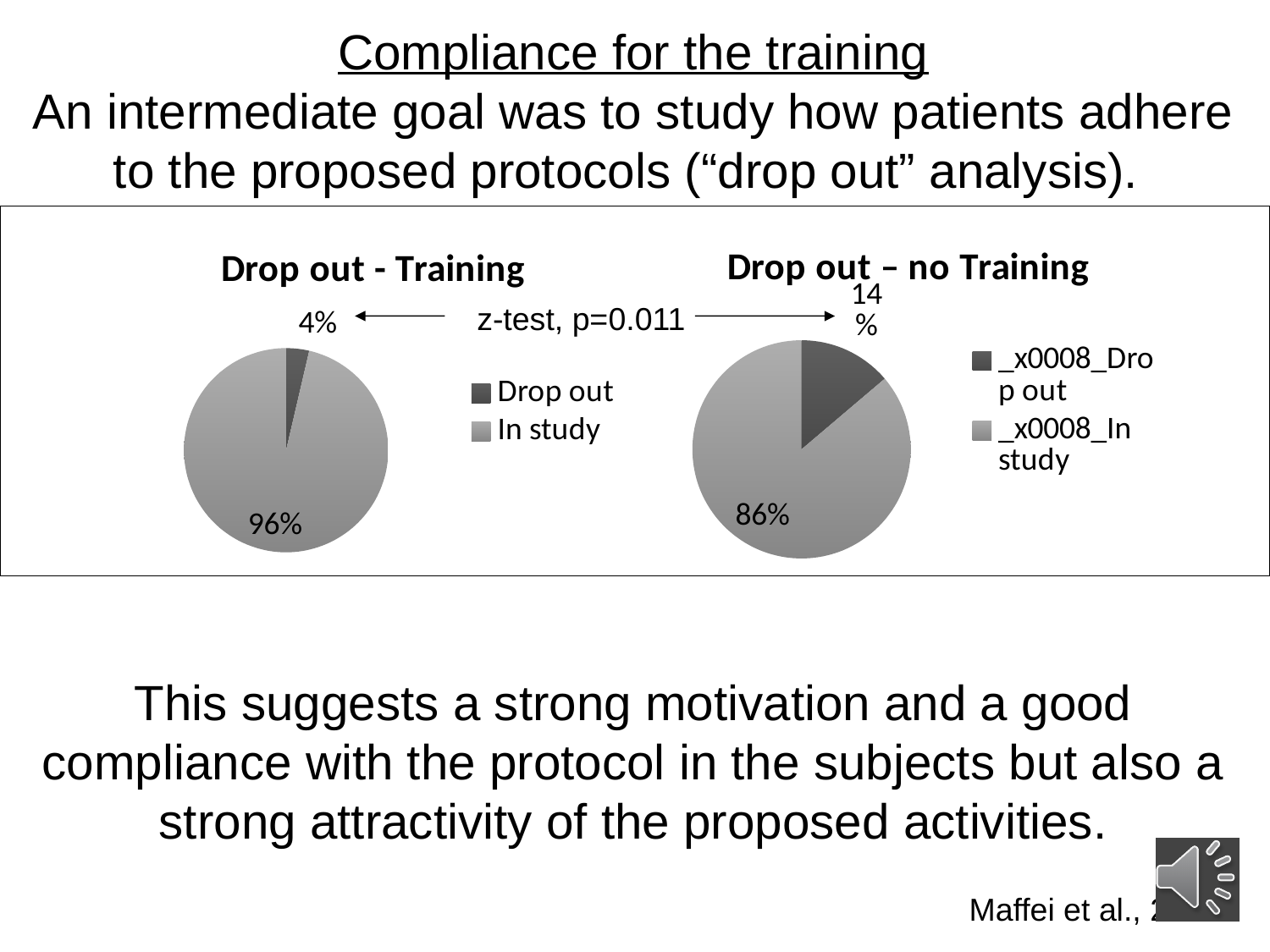
In the 'Drop out - Training' chart, what percentage of patients dropped out? 4% In the 'Drop out – no Training' chart, which slice is the largest? In study What kind of chart is 'Drop out - Training'? Pie chart In the 'Drop out – no Training' chart, what percentage of patients remained in the study? 86% How many slices does the 'Drop out - Training' pie chart have? 2 What statistical test result is shown between the two pie charts? z-test, p=0.011 What is the difference between the drop-out percentage in the 'Drop out – no Training' chart and the 'Drop out - Training' chart? 10% How many entries does the legend of the 'Drop out - Training' chart list? 2 In the 'Drop out – no Training' chart, what percentage of patients dropped out? 14% Which chart shows the larger drop-out share, 'Drop out - Training' or 'Drop out – no Training'? Drop out – no Training In the 'Drop out - Training' chart, what percentage of patients remained in the study? 96% In the 'Drop out - Training' chart, which slice is the smallest? Drop out